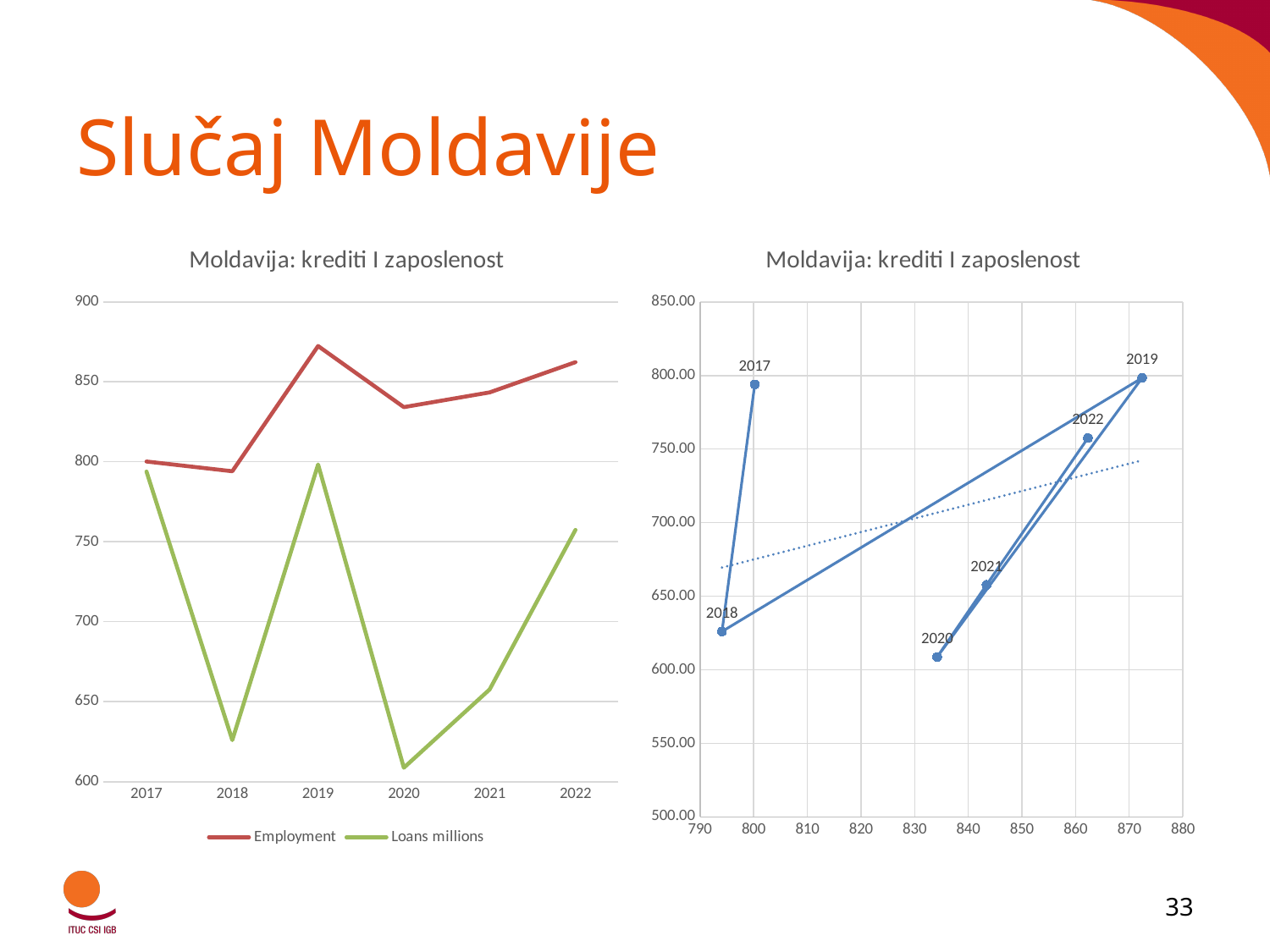
On the left chart, how many series does the legend list? 2 On the left chart, what kind of chart is it? line chart On the left chart, how many years are shown on the x axis? 6 On the left chart, in which year is Loans millions lowest? 2020 On the left chart, which year has the larger Loans millions value, 2021 or 2022? 2022 On the left chart, what colour is the Employment line? red On the right chart, which year's point is furthest to the right on the horizontal axis? 2019 On the left chart, in which year is Employment highest? 2019 On the left chart, does Employment rise or fall from 2020 to 2022? rise On the left chart, is the Loans millions value for 2018 greater or less than 650? less On the right chart, which year's point is lowest on the vertical axis? 2020 On the left chart, is the Employment value for 2019 greater or less than 850? greater